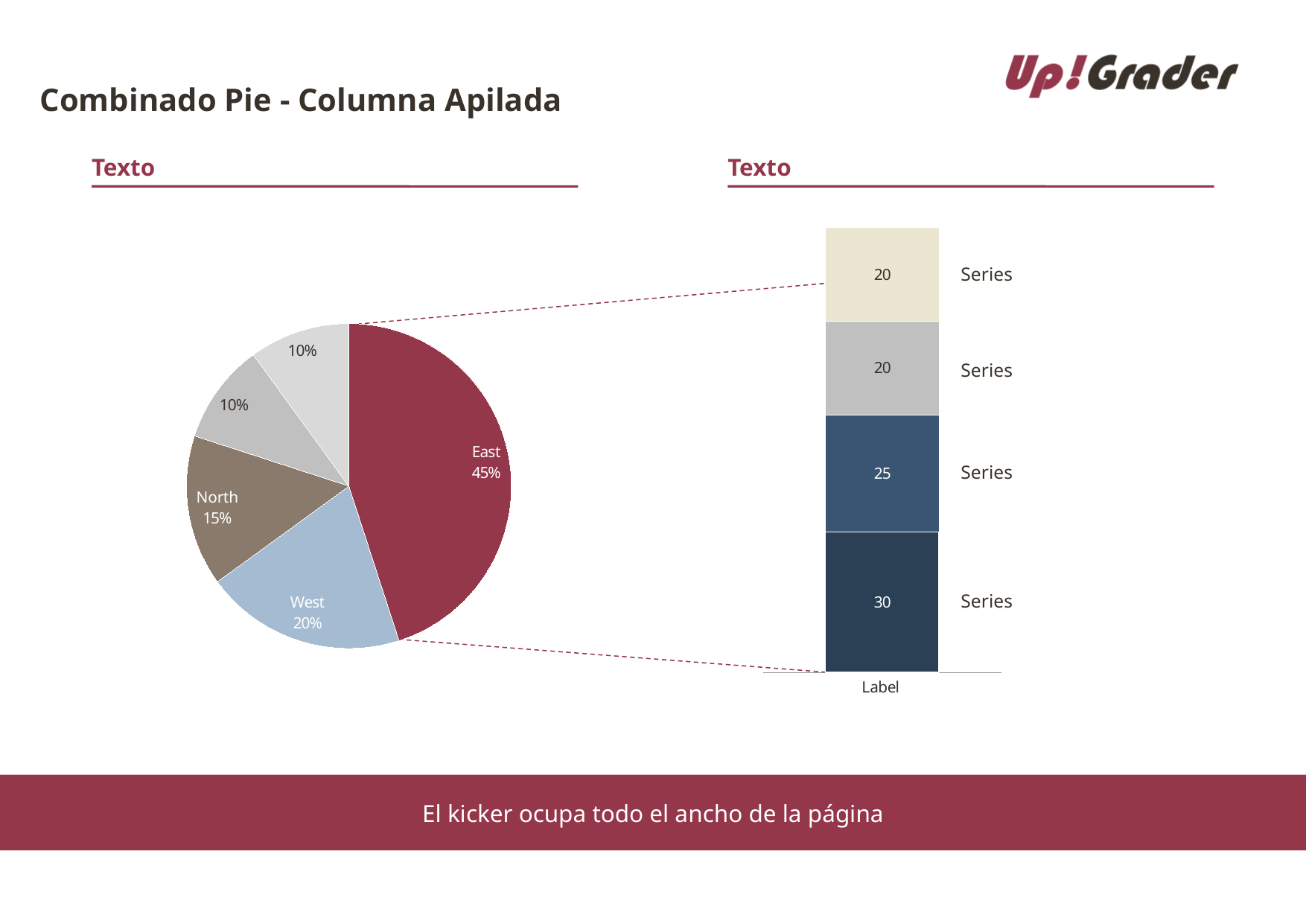
In the pie chart on the left, which labelled slice is the largest? East In the pie chart on the left, what is the difference between the East and West shares? 25% In the pie chart on the left, what is the value shown for West? 20% What kind of chart is on the right side of the slide? Stacked bar chart In the pie chart on the left, what share does the East slice have? 45% In the stacked bar chart on the right, what is the value of the bottom segment? 30 In the stacked bar chart on the right, how many segments make up the bar? 4 In the stacked bar chart on the right, what is the total of the stacked bar? 95 In the pie chart on the left, how many slices are there? 5 What kind of chart is on the left side of the slide? Pie chart In the pie chart on the left, which is larger, West or North? West In the pie chart on the left, what is the value shown for North? 15%